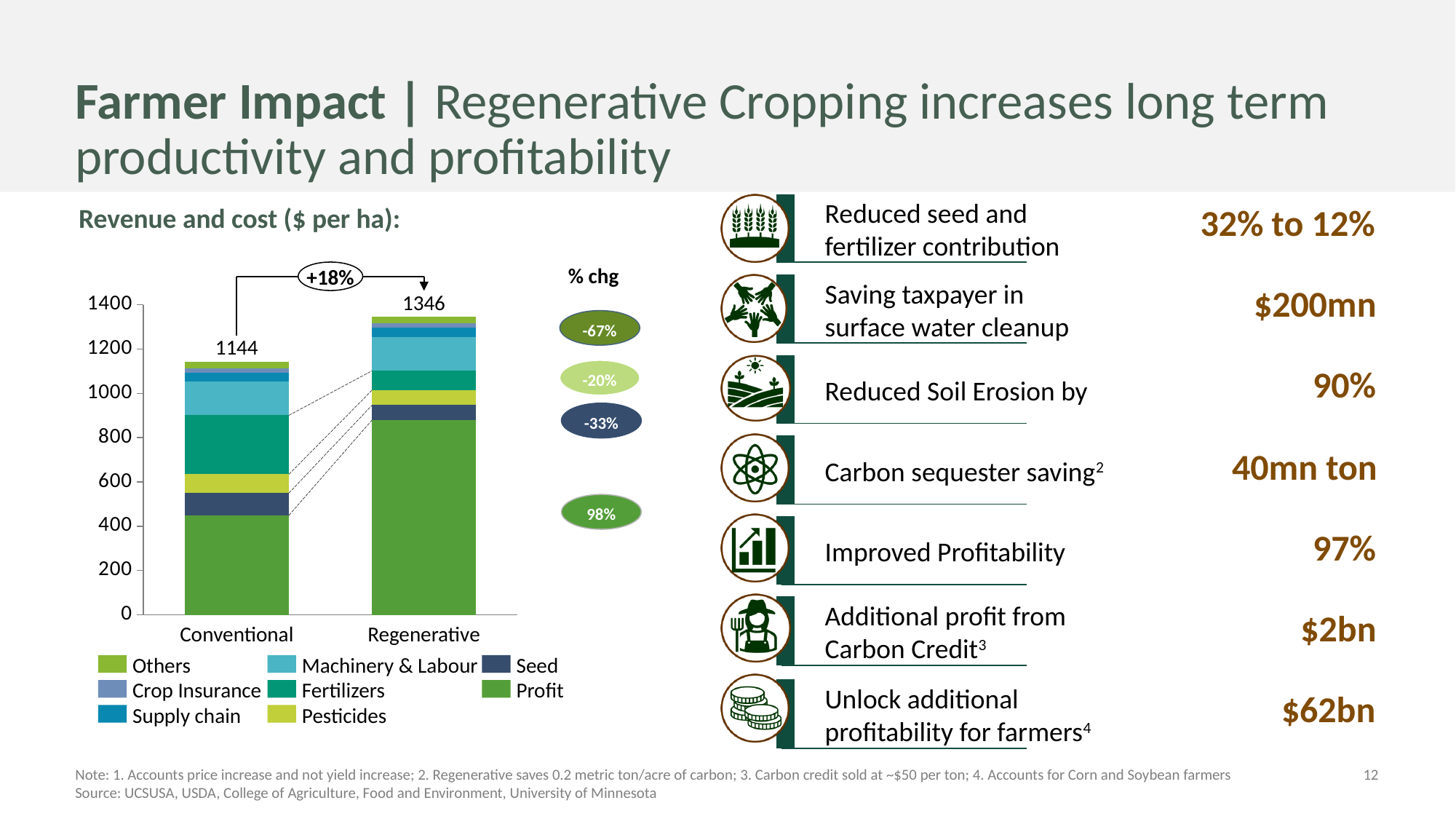
Which bar has the larger Fertilizers segment, Conventional or Regenerative? Conventional How many categories are shown on the x axis of the chart? 2 Which category has the higher total, Conventional or Regenerative? Regenerative Is the Profit segment for Conventional greater or less than 600? less What is the total value shown for the Regenerative bar? 1346 How many series does the chart legend list? 8 What is the difference between the Regenerative total and the Conventional total? 202 What kind of chart is shown on the slide? Stacked bar chart What is the total value shown for the Conventional bar? 1144 Is the Profit segment for Regenerative greater or less than 800? greater Which bar has the larger Profit segment, Conventional or Regenerative? Regenerative What percentage change is shown between the Conventional and Regenerative totals? +18%